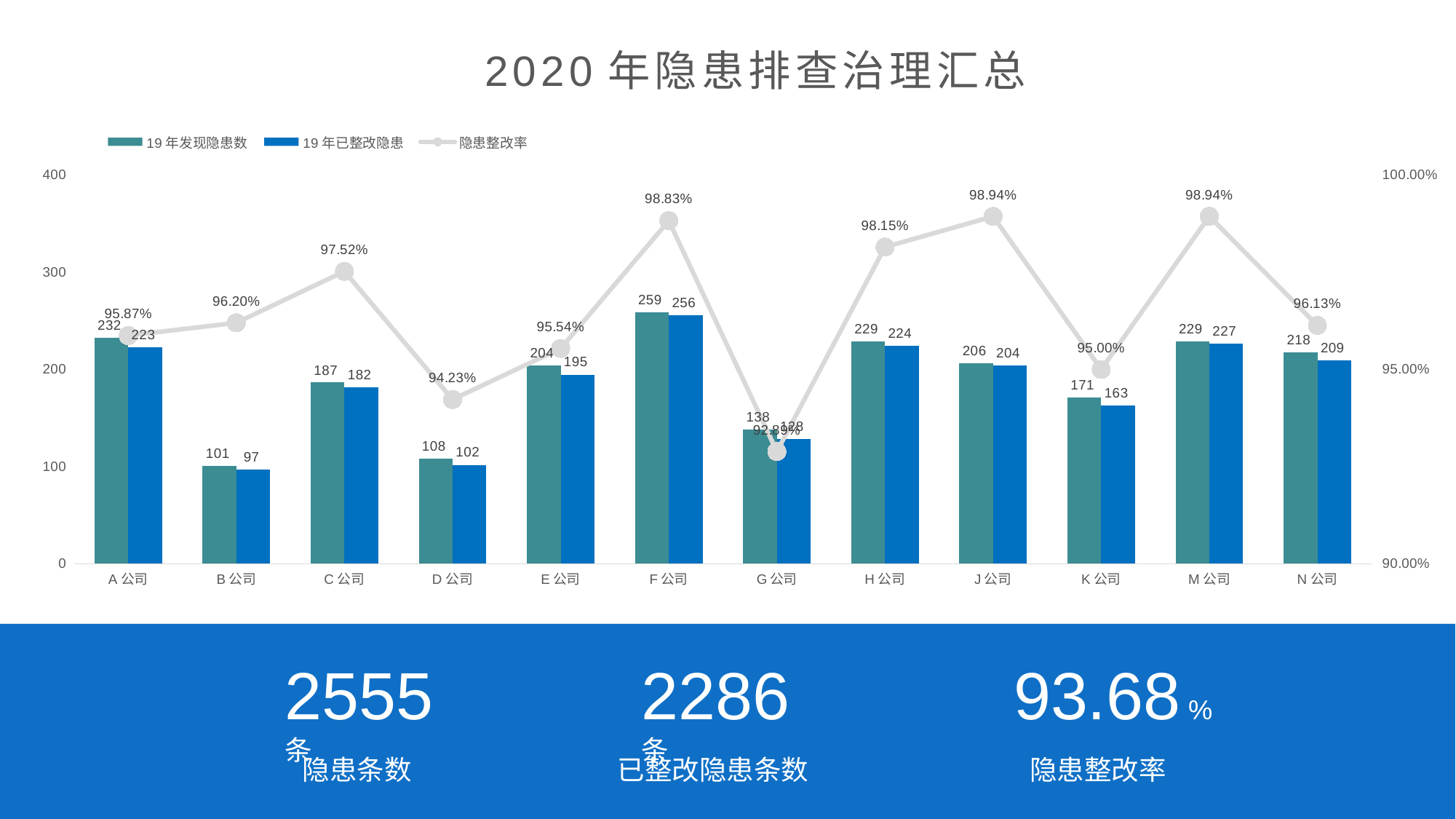
What kind of chart is this? Combined bar and line chart What is the 隐患整改率 for C 公司? 97.52% What is the value of 19 年已整改隐患 for K 公司? 163 Which company has the lowest 19 年已整改隐患? B 公司 What is the difference between 19 年发现隐患数 and 19 年已整改隐患 for K 公司? 8 What is the value of 19 年发现隐患数 for F 公司? 259 Which is larger, the 19 年发现隐患数 for A 公司 or for N 公司? A 公司 What is the title of the chart? 2020 年隐患排查治理汇总 How many series does the legend list? 3 How many companies are shown on the x axis? 12 Is the 19 年发现隐患数 for D 公司 greater or less than 200? less Which company has the highest 19 年发现隐患数? F 公司